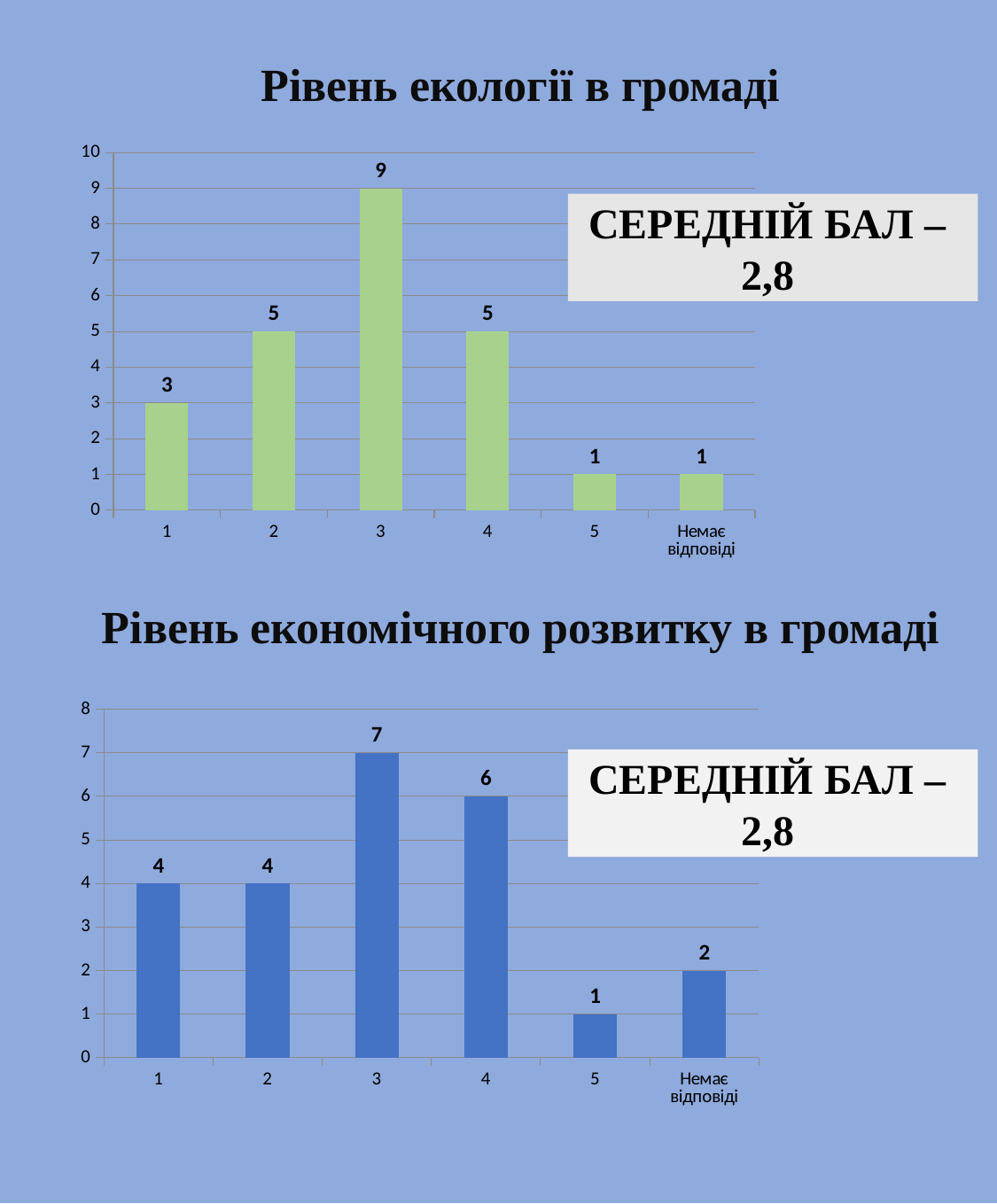
In the chart 'Рівень екології в громаді', what is the value for 'Немає відповіді'? 1 In the chart 'Рівень екології в громаді', which category has the highest value? 3 What kind of chart is 'Рівень економічного розвитку в громаді'? bar chart What average score (СЕРЕДНІЙ БАЛ) is shown next to the chart 'Рівень екології в громаді'? 2,8 In the chart 'Рівень екології в громаді', what is the difference between the values for category 3 and category 1? 6 In the chart 'Рівень економічного розвитку в громаді', what is the difference between the values for category 4 and 'Немає відповіді'? 4 In the chart 'Рівень екології в громаді', how many categories are shown on the x axis? 6 In the chart 'Рівень економічного розвитку в громаді', which category has the lowest value? 5 In the chart 'Рівень економічного розвитку в громаді', what is the value for category 1? 4 In the chart 'Рівень економічного розвитку в громаді', which is larger: the value for category 3 or the value for category 4? category 3 In the chart 'Рівень економічного розвитку в громаді', what is the value for category 4? 6 In the chart 'Рівень екології в громаді', what is the value for category 3? 9